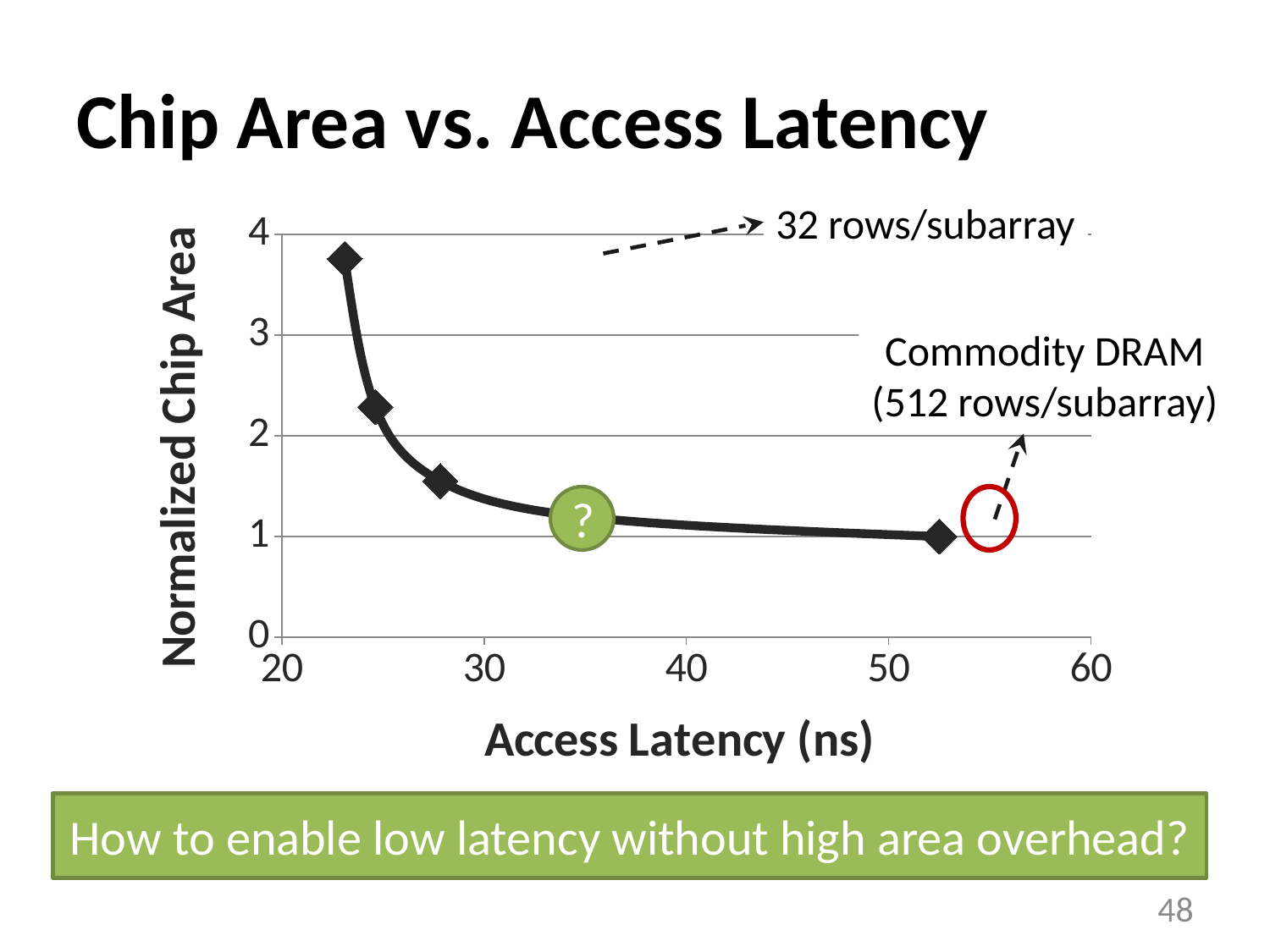
Is the access latency of the leftmost data point greater or less than 30 ns? less Is the normalized chip area for the third data point from the left greater or less than 2? less Which data point has the highest normalized chip area: the one with the lowest access latency or the one with the highest access latency? the one with the lowest access latency According to the annotation, how many rows per subarray does commodity DRAM have? 512 rows/subarray What kind of chart is shown on the slide? line chart Is the normalized chip area for the second data point from the left greater or less than 2? greater What is the label of the x axis? Access Latency (ns) As access latency increases along the x axis, does normalized chip area rise or fall? fall